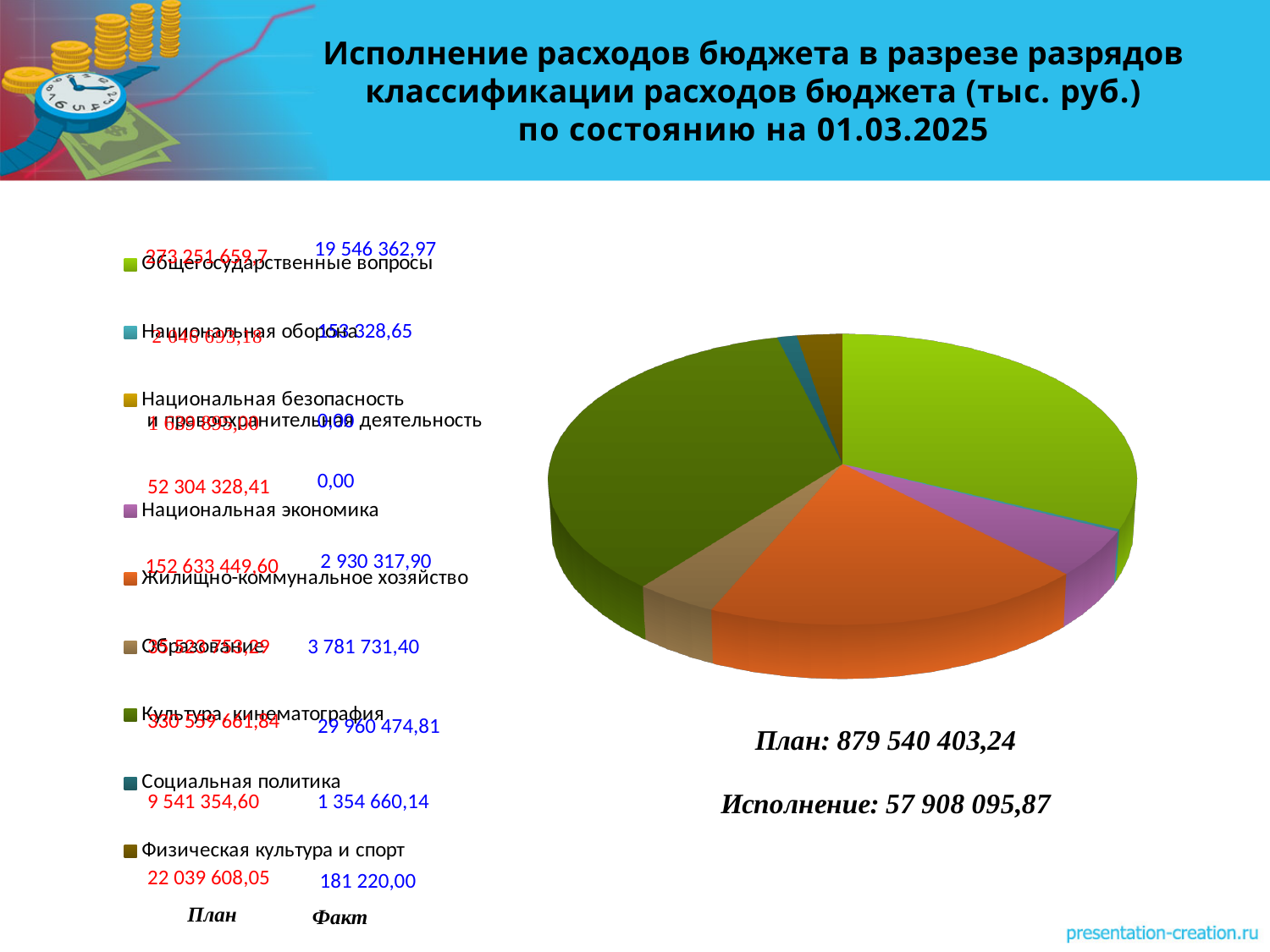
What kind of chart is shown on the slide? Pie chart What is the Факт value for Физическая культура и спорт? 181 220,00 Which category has the largest slice in the pie chart? Культура, кинематография What is the difference between the Факт values for Социальная политика and Физическая культура и спорт? 1 173 440,14 What is the Факт value for Социальная политика? 1 354 660,14 What total Исполнение value is printed below the pie chart? 57 908 095,87 What is the Факт value for Жилищно-коммунальное хозяйство? 2 930 317,90 How many categories does the legend of the pie chart list? 9 What is the План value for Национальная экономика? 52 304 328,41 What is the План value for Физическая культура и спорт? 22 039 608,05 Which has the larger Факт value: Социальная политика or Физическая культура и спорт? Социальная политика What is the Факт value for Общегосударственные вопросы? 19 546 362,97